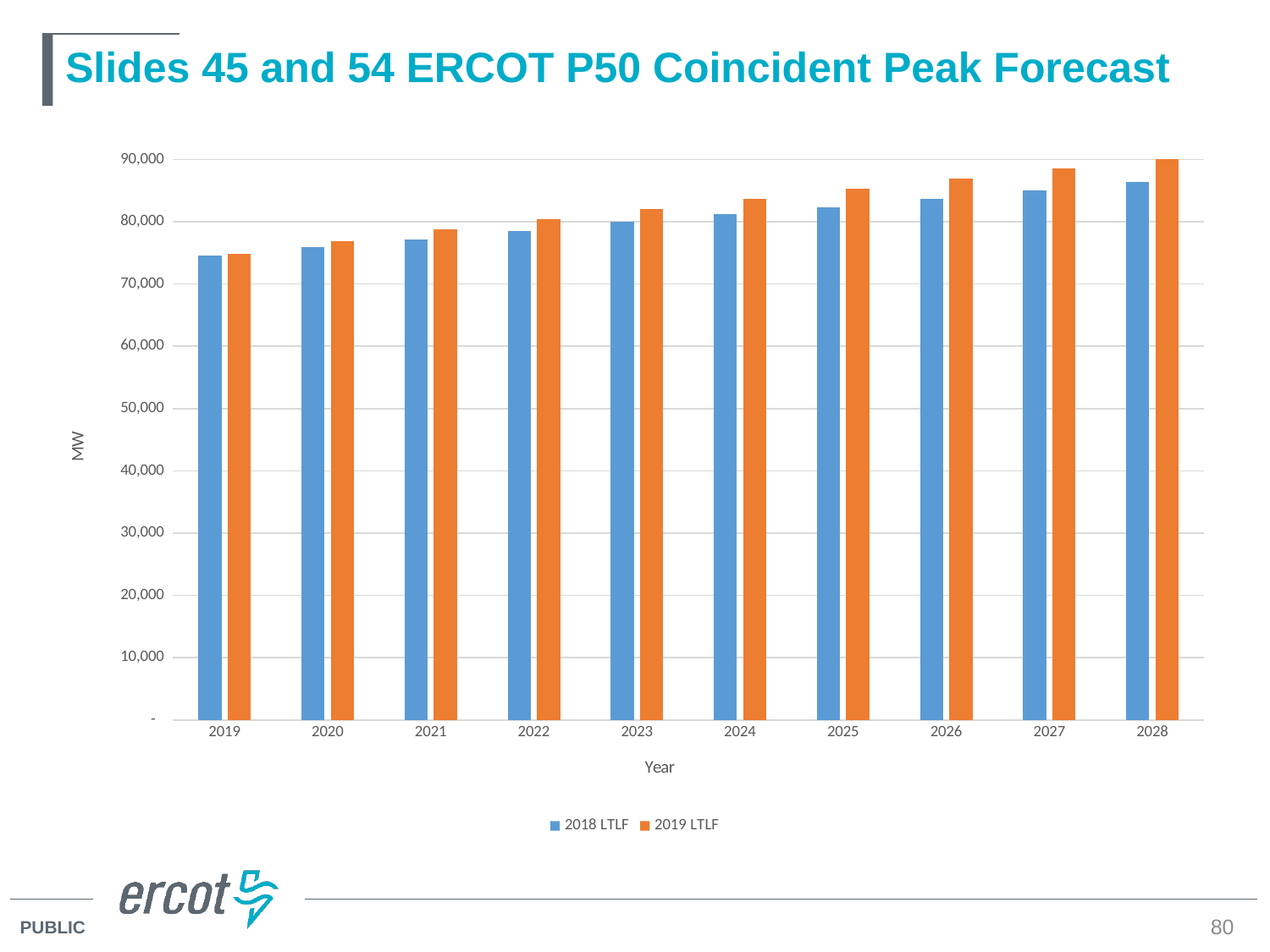
Is the 2019 LTLF value for 2028 greater or less than 80,000? greater What is the label on the vertical axis? MW Is the 2019 LTLF value for 2026 greater or less than 80,000? greater Is the 2018 LTLF value for 2019 greater or less than 80,000? less In which year is the 2018 LTLF value lowest? 2019 In which year is the 2019 LTLF value highest? 2028 What kind of chart is shown on the slide? bar chart How many years are shown on the x axis? 10 How many series does the legend list? 2 Do the 2019 LTLF values rise or fall from 2019 to 2028? rise For 2028, which series has the larger value, 2018 LTLF or 2019 LTLF? 2019 LTLF